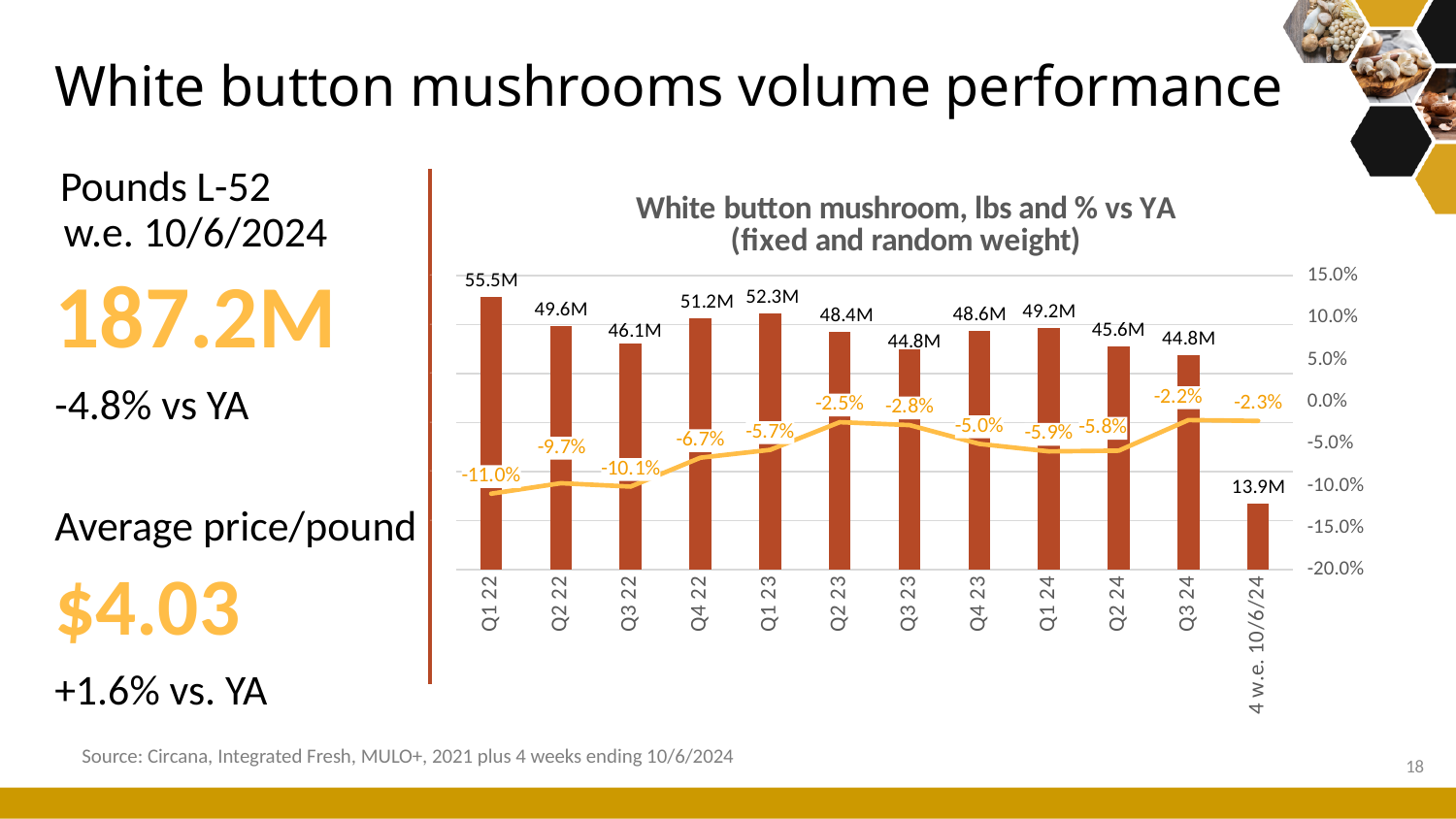
Does the % vs YA line rise or fall from Q1 22 to Q2 23? Rise What kind of chart is this? Combination bar and line chart What is the title of the chart? White button mushroom, lbs and % vs YA (fixed and random weight) Which period has the highest volume in pounds? Q1 22 Which period has the lowest % vs YA value? Q1 22 What is the volume in pounds for Q1 22? 55.5M Which has the larger volume in pounds, Q4 22 or Q1 23? Q1 23 What is the difference in pounds between Q1 22 and Q2 22? 5.9M How many periods are shown on the x axis? 12 What is the volume in pounds for the 4 w.e. 10/6/24 period? 13.9M What is the % vs YA value for Q4 22? -6.7% What is the % vs YA value for Q3 24? -2.2%